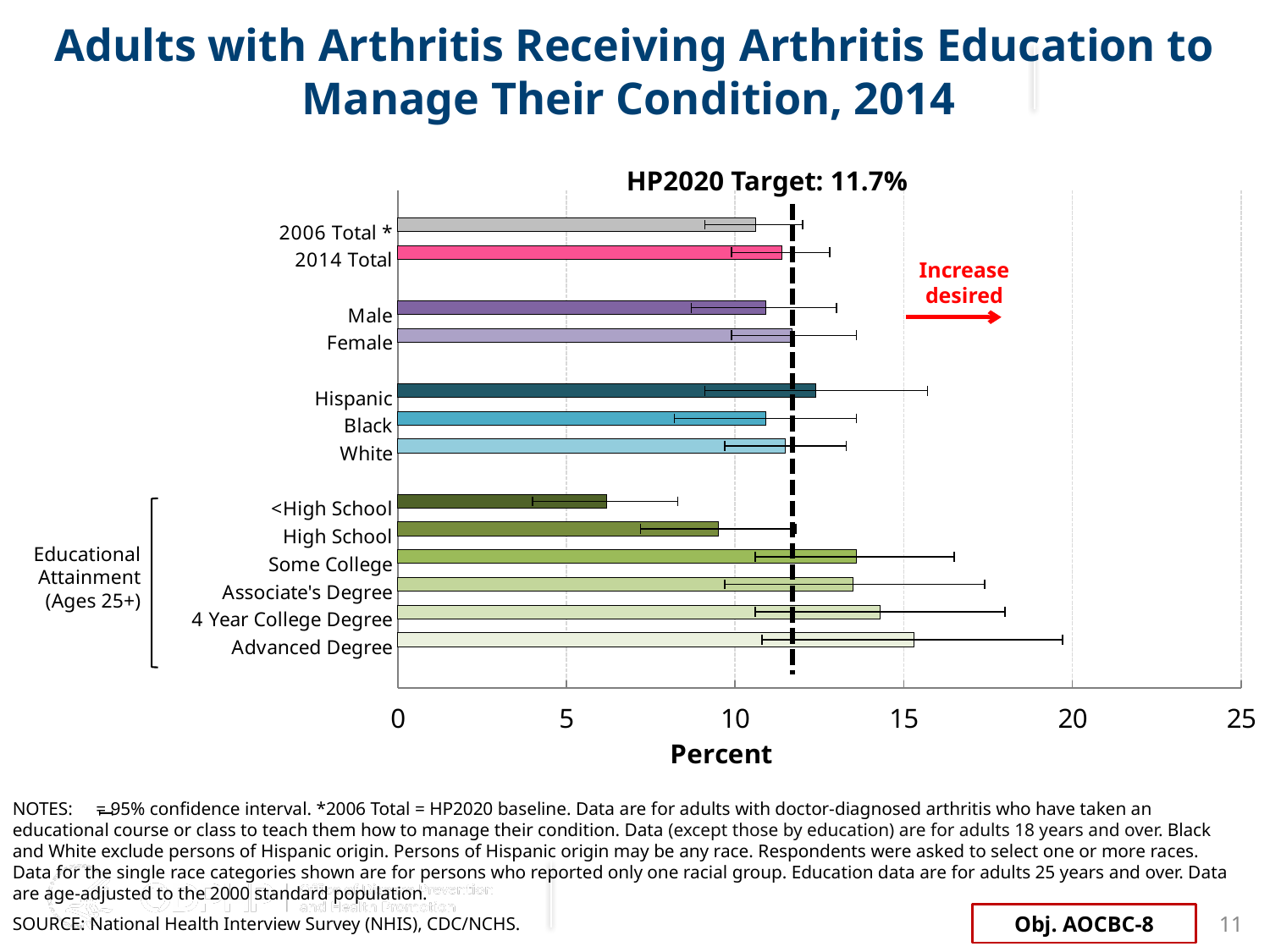
Is the value for Advanced Degree greater or less than 10? greater Which is larger, the value for Hispanic or the value for Black? Hispanic Which category has the lowest value? <High School What kind of chart is shown on the slide? bar chart How many bars are plotted in the chart? 13 Is the value for Hispanic greater or less than 10? greater What is the HP2020 Target shown on the chart? 11.7% Is the value for <High School greater or less than 10? less Which category has the highest value? Advanced Degree Which is larger, the value for Some College or the value for High School? Some College